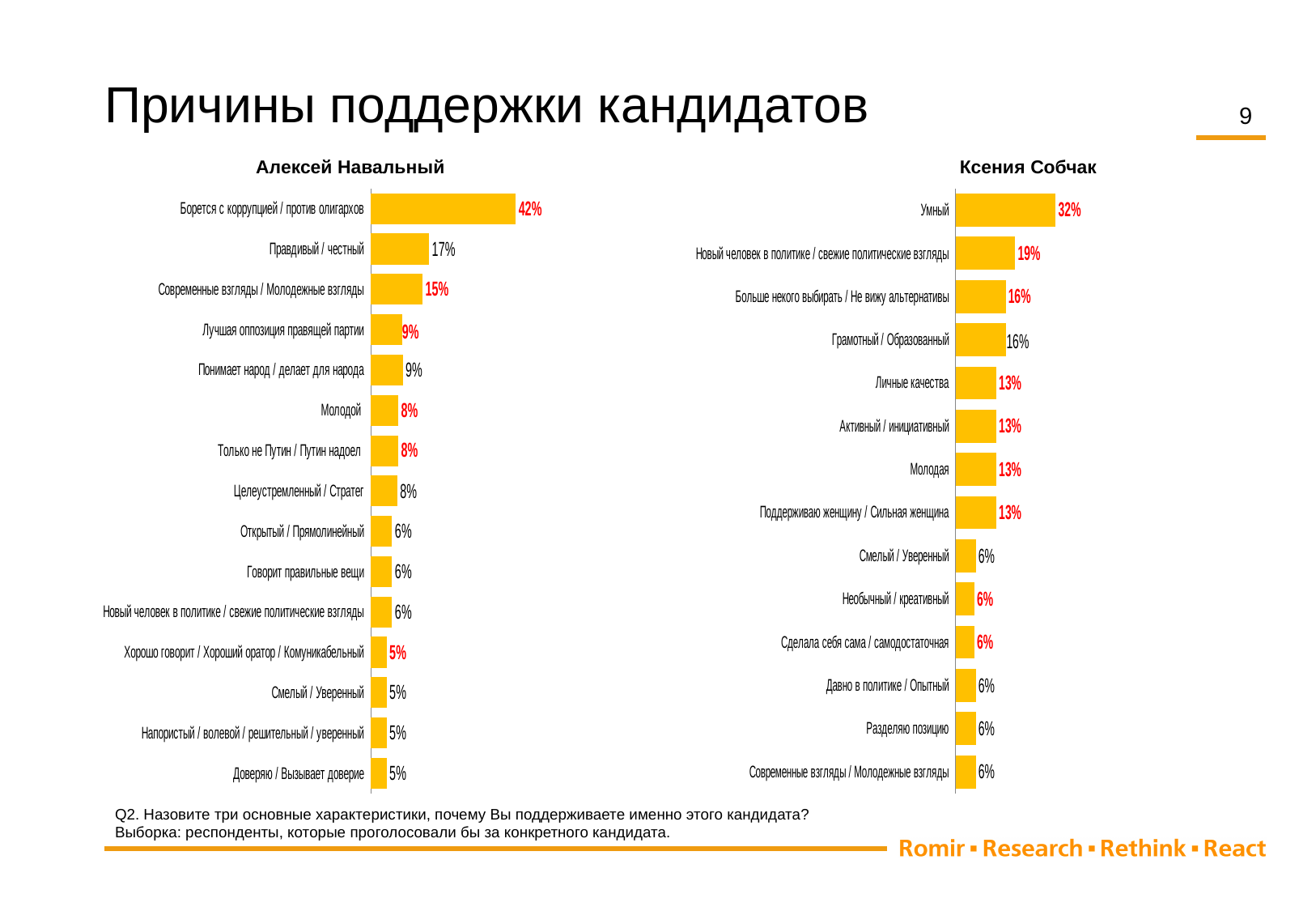
How many categories are shown on the Алексей Навальный chart? 15 On the Ксения Собчак chart, which category has the highest value? Умный On the Алексей Навальный chart, what is the value for Правдивый / честный? 17% On the Алексей Навальный chart, which category has the highest value? Борется с коррупцией / против олигархов On the Алексей Навальный chart, what is the value for Борется с коррупцией / против олигархов? 42% On the Алексей Навальный chart, which is larger: Современные взгляды / Молодежные взгляды or Молодой? Современные взгляды / Молодежные взгляды How many categories are shown on the Ксения Собчак chart? 14 On the Ксения Собчак chart, which is larger: Личные качества or Смелый / Уверенный? Личные качества On the Ксения Собчак chart, what is the value for Новый человек в политике / свежие политические взгляды? 19% What type of chart is used for Ксения Собчак? Bar chart On the Ксения Собчак chart, what is the difference between Умный and Новый человек в политике / свежие политические взгляды? 13% On the Алексей Навальный chart, what is the difference between Борется с коррупцией / против олигархов and Правдивый / честный? 25%